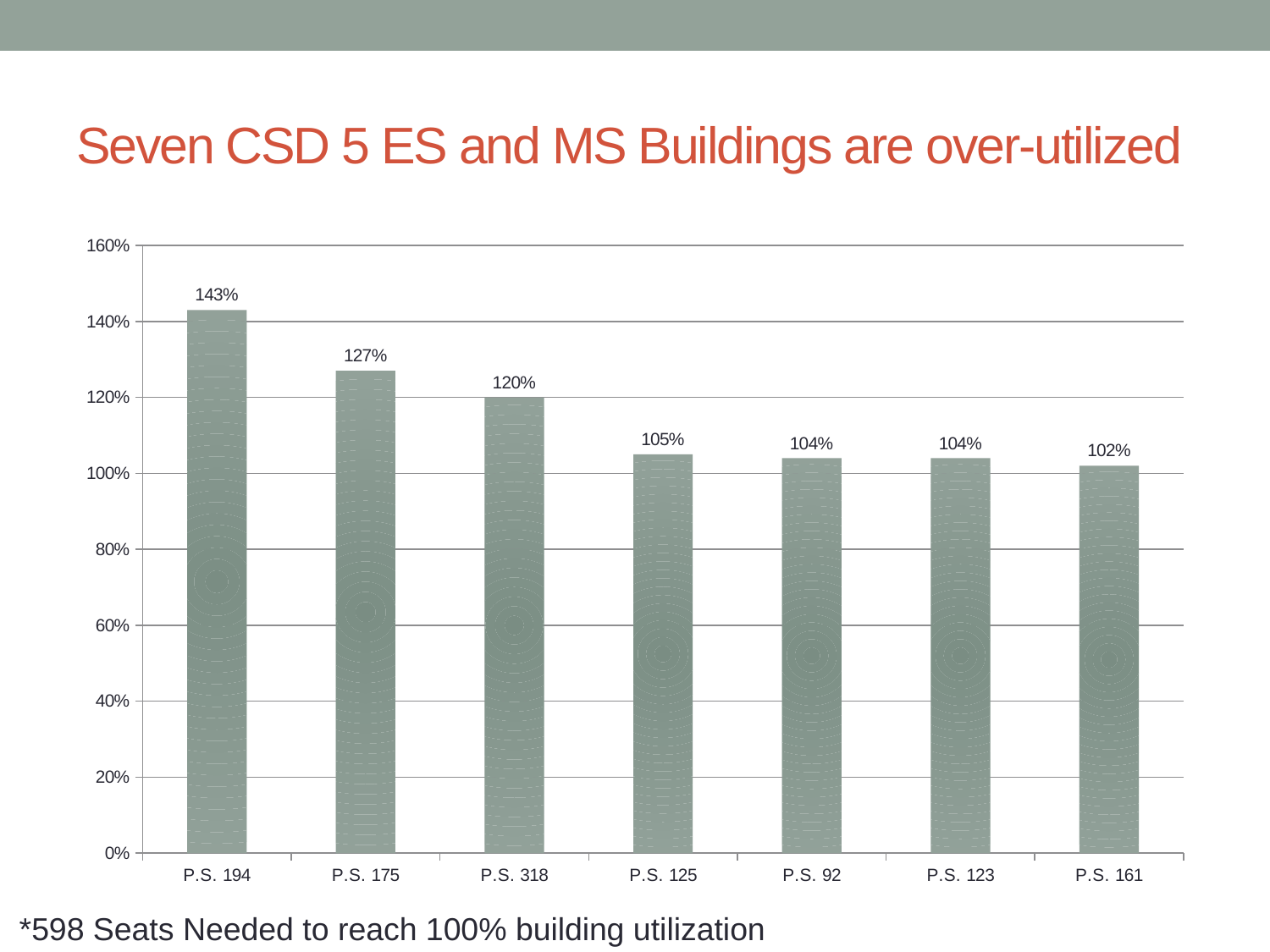
What is the utilization value for P.S. 194? 143% What is the utilization value for P.S. 318? 120% What is the difference between the utilization of P.S. 194 and P.S. 175? 16% What is the utilization value for P.S. 161? 102% Do the values rise or fall from left to right along the x axis? Fall Which has a higher utilization, P.S. 175 or P.S. 125? P.S. 175 Which school has the lowest utilization? P.S. 161 What kind of chart is shown on the slide? Bar chart How many schools are shown on the chart? 7 Which school has the highest utilization? P.S. 194 What is the difference between the utilization of P.S. 318 and P.S. 125? 15% Is the value for P.S. 194 greater or less than 140%? greater